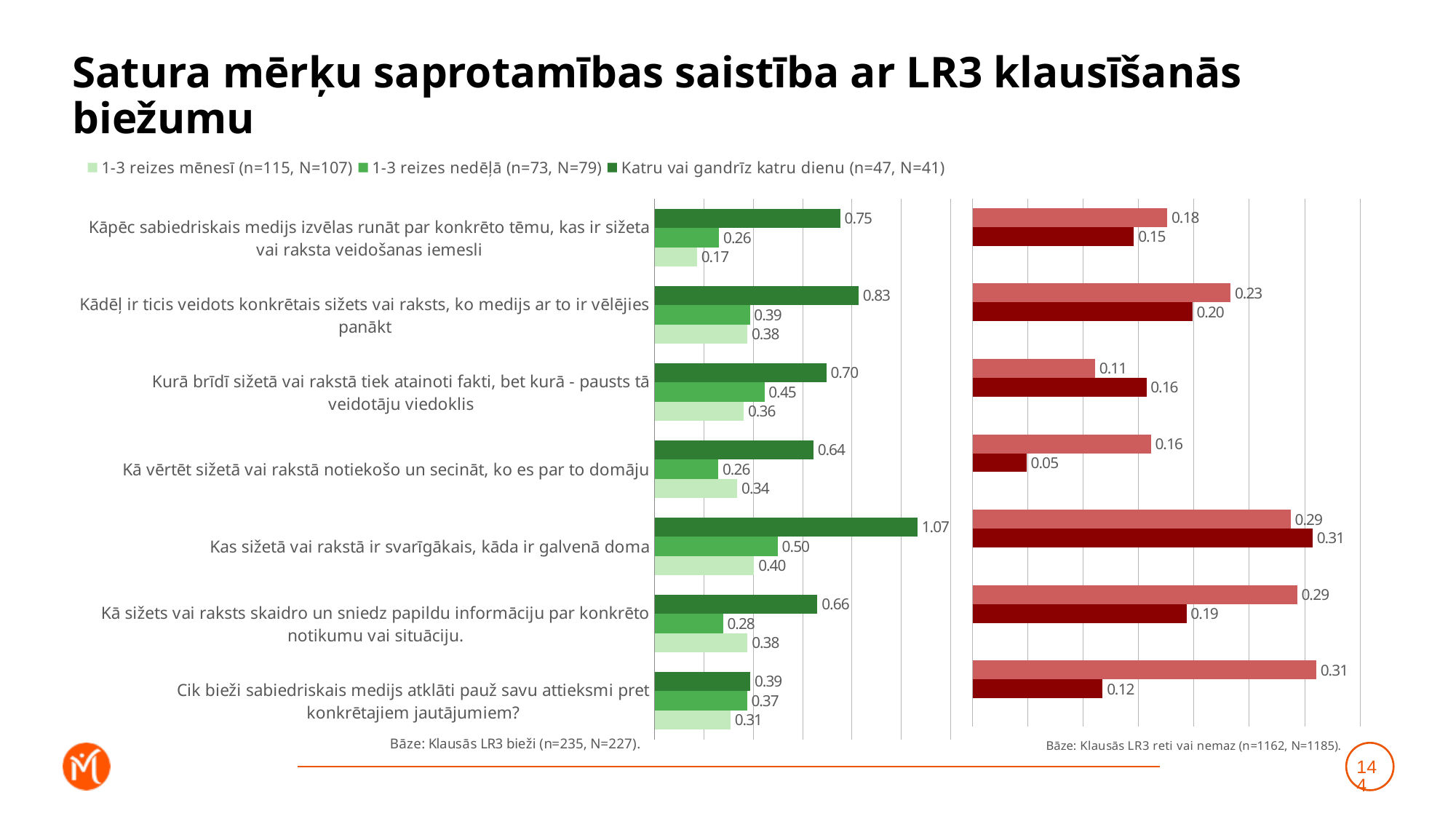
In the legend of the left chart, what is the full label of the dark green series? Katru vai gandrīz katru dienu (n=47, N=41) What kind of chart is the right chart (Bāze: Klausās LR3 reti vai nemaz)? Bar chart In the right chart (Bāze: Klausās LR3 reti vai nemaz), which category has the highest value among the lighter red bars? Cik bieži sabiedriskais medijs atklāti pauž savu attieksmi pret konkrētajiem jautājumiem? How many series does the legend of the left chart (Bāze: Klausās LR3 bieži) list? 3 In the left chart (Bāze: Klausās LR3 bieži), what is the value for '1-3 reizes mēnesī' for the category 'Kāpēc sabiedriskais medijs izvēlas runāt par konkrēto tēmu, kas ir sižeta vai raksta veidošanas iemesli'? 0.17 In the right chart (Bāze: Klausās LR3 reti vai nemaz), what is the value of the darker red bar for the category 'Kā vērtēt sižetā vai rakstā notiekošo un secināt, ko es par to domāju'? 0.05 In the left chart (Bāze: Klausās LR3 bieži), which category has the larger '1-3 reizes nedēļā' value: 'Kurā brīdī sižetā vai rakstā tiek atainoti fakti, bet kurā - pausts tā veidotāju viedoklis' or 'Kā vērtēt sižetā vai rakstā notiekošo un secināt, ko es par to domāju'? Kurā brīdī sižetā vai rakstā tiek atainoti fakti, bet kurā - pausts tā veidotāju viedoklis How many categories are shown in the left chart (Bāze: Klausās LR3 bieži)? 7 In the left chart (Bāze: Klausās LR3 bieži), what is the value for 'Katru vai gandrīz katru dienu' for the category 'Kas sižetā vai rakstā ir svarīgākais, kāda ir galvenā doma'? 1.07 In the left chart (Bāze: Klausās LR3 bieži), which category has the highest value for 'Katru vai gandrīz katru dienu'? Kas sižetā vai rakstā ir svarīgākais, kāda ir galvenā doma In the left chart (Bāze: Klausās LR3 bieži), which category has the lowest value for 'Katru vai gandrīz katru dienu'? Cik bieži sabiedriskais medijs atklāti pauž savu attieksmi pret konkrētajiem jautājumiem? In the left chart (Bāze: Klausās LR3 bieži), for the category 'Kādēļ ir ticis veidots konkrētais sižets vai raksts, ko medijs ar to ir vēlējies panākt', what is the difference between the 'Katru vai gandrīz katru dienu' value and the '1-3 reizes mēnesī' value? 0.45